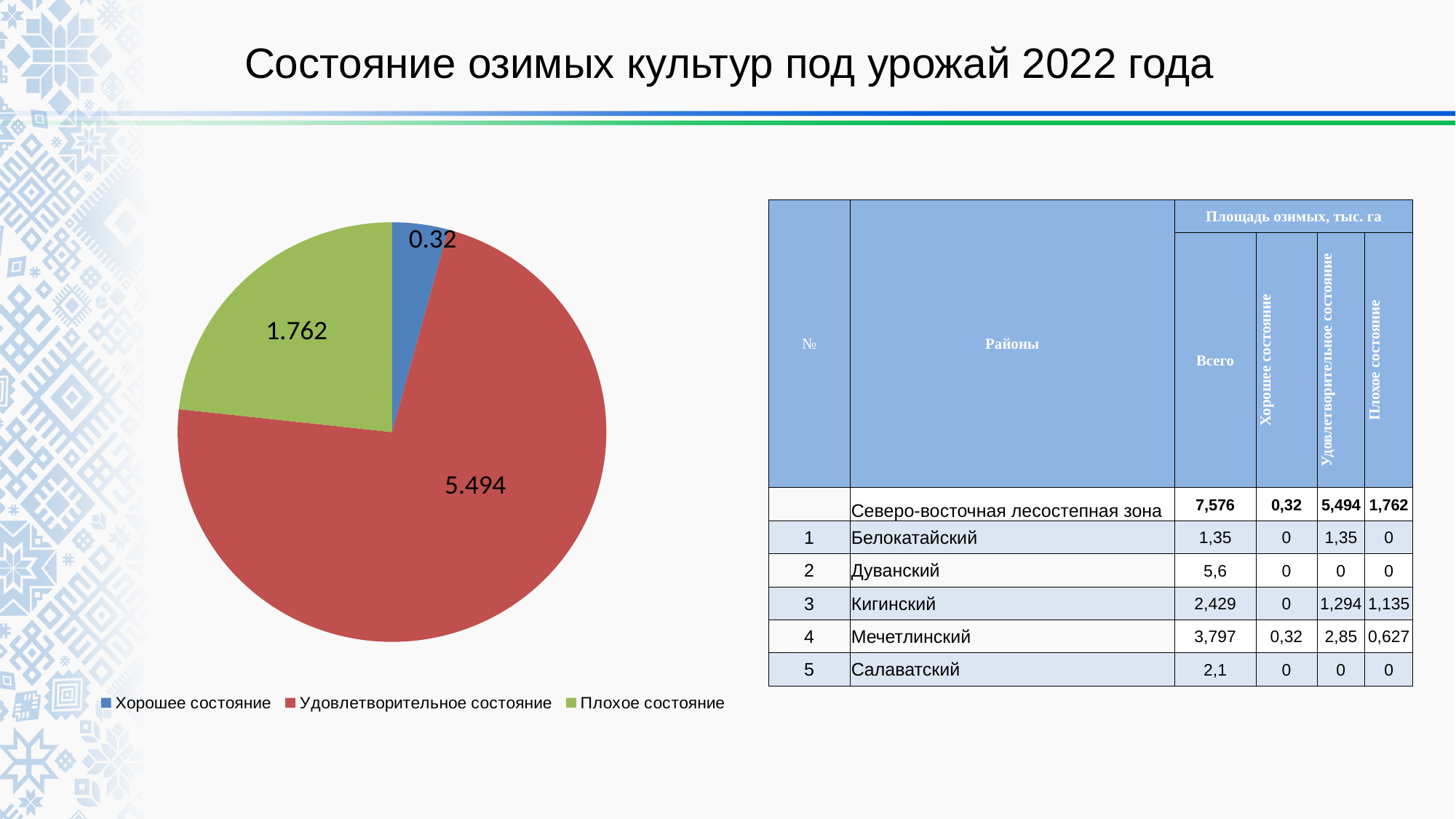
What is the value of the Плохое состояние slice in the pie chart? 1.762 Which category has the smallest slice in the pie chart? Хорошее состояние What is the value of the Хорошее состояние slice in the pie chart? 0.32 What colour is the Удовлетворительное состояние slice in the pie chart? red How many slices does the pie chart have? 3 Which is larger in the pie chart: Плохое состояние or Хорошее состояние? Плохое состояние Which category has the largest slice in the pie chart? Удовлетворительное состояние What is the difference between the Плохое состояние and Хорошее состояние values in the pie chart? 1.442 What is the value of the Удовлетворительное состояние slice in the pie chart? 5.494 What is the difference between the Удовлетворительное состояние and Плохое состояние values in the pie chart? 3.732 What kind of chart is shown on the slide? pie chart How many entries does the pie chart legend list? 3